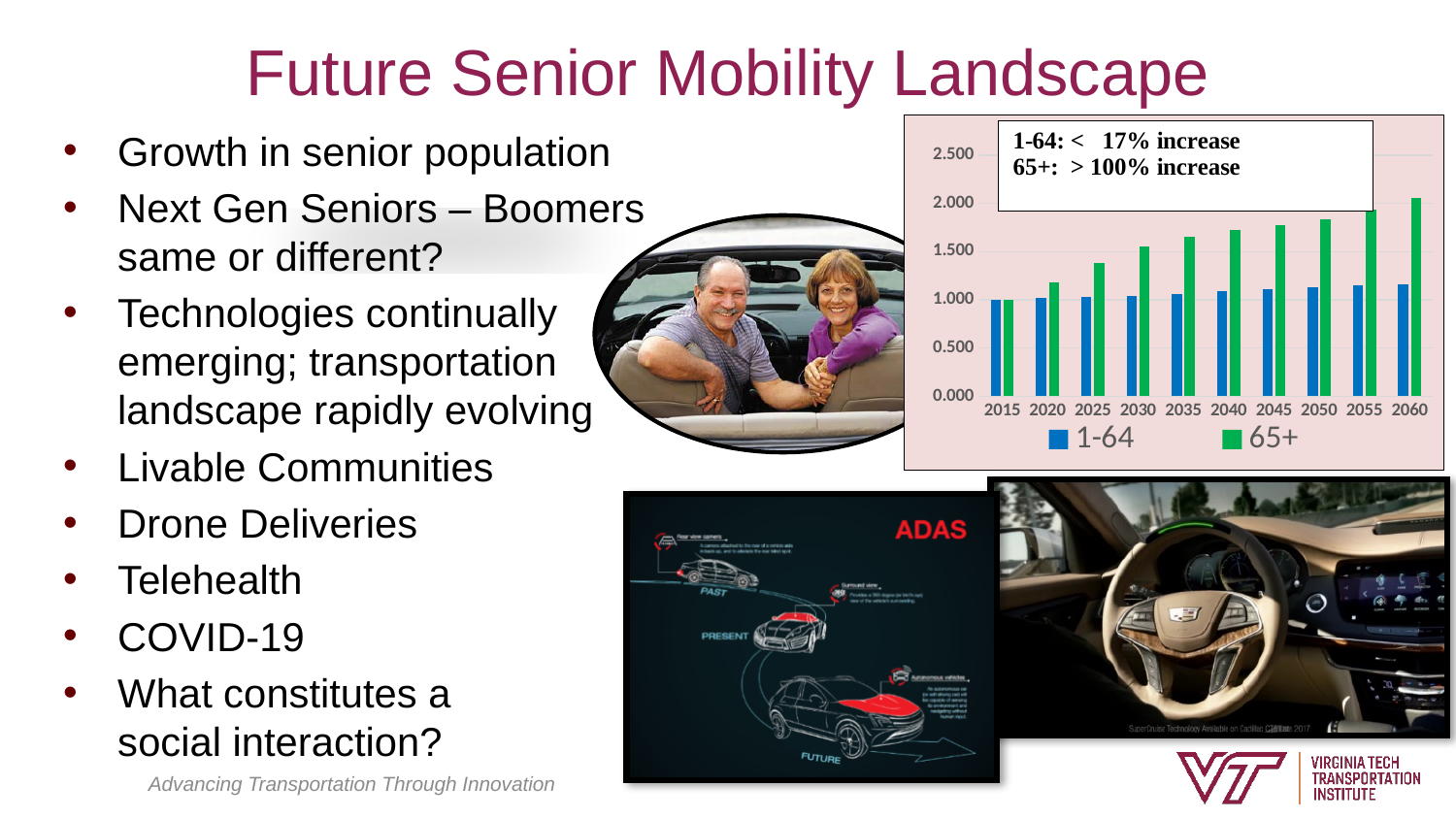
In which year is the 65+ bar the lowest? 2015 Do the values for the 65+ series rise or fall from 2015 to 2060? rise What colour are the bars for the 65+ series? green Which two series are listed in the chart's legend? 1-64 and 65+ Is the value for 65+ in 2040 greater or less than 1.500? greater In 2060, which series has the larger value, 1-64 or 65+? 65+ In which year is the 65+ bar the highest? 2060 How many years are shown on the x axis of the chart? 10 Is the value for 1-64 in 2060 greater or less than 1.500? less Is the value for 65+ in 2025 greater or less than 1.500? less How many series does the chart's legend list? 2 What kind of chart is shown on the slide? bar chart